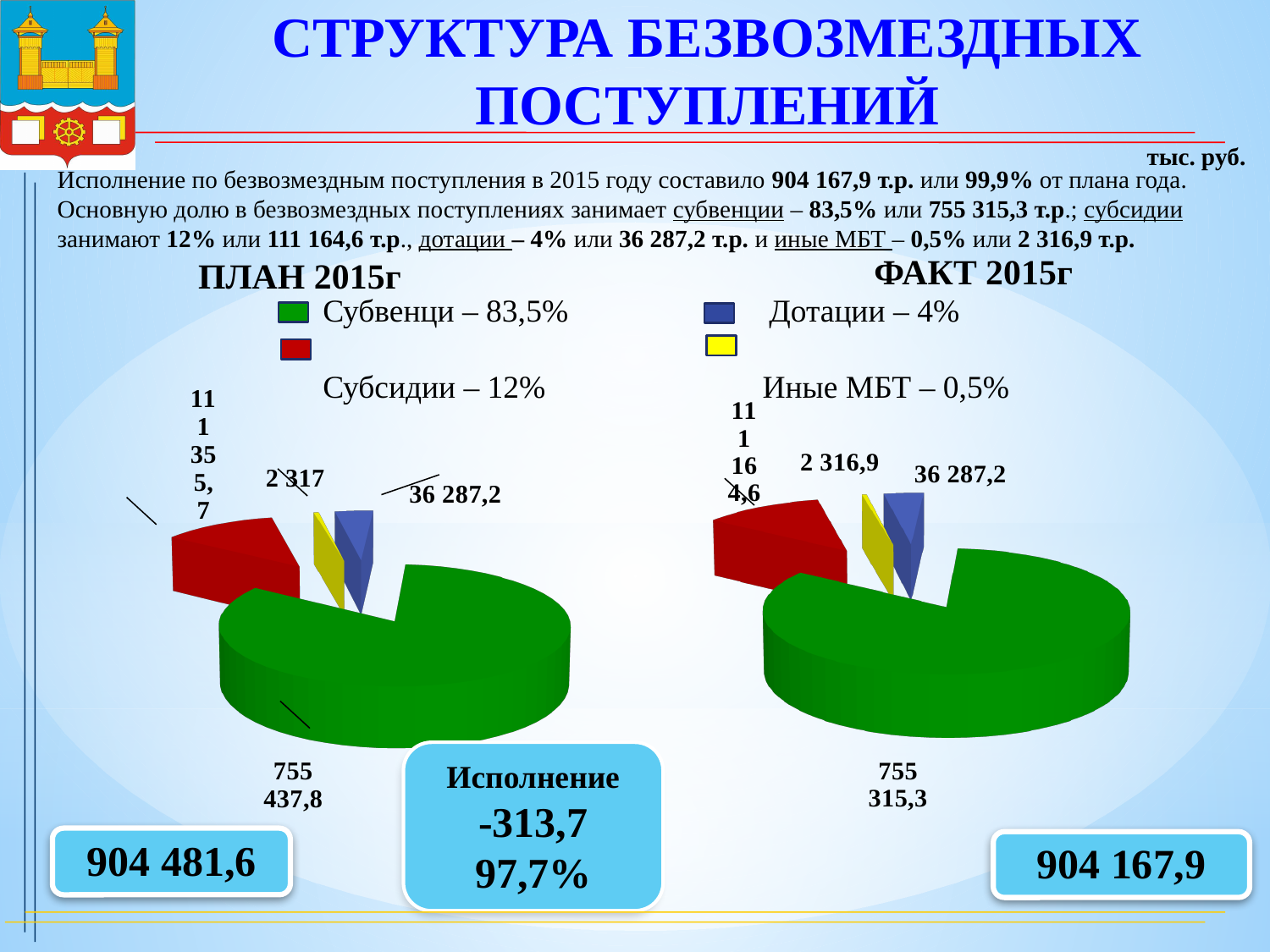
In the ФАКТ 2015г chart, what is the value of the Субсидии slice? 111 164,6 In the ПЛАН 2015г chart, which is larger: Субсидии or Дотации? Субсидии How many slices does the ФАКТ 2015г pie chart have? 4 What type of chart is used for ПЛАН 2015г and ФАКТ 2015г? Pie chart In the ПЛАН 2015г chart, what is the value of the Субвенции slice? 755 437,8 In the ПЛАН 2015г chart, which category has the smallest slice? Иные МБТ In the ФАКТ 2015г chart, which category has the largest slice? Субвенции In the ФАКТ 2015г chart, what is the value of the Дотации slice? 36 287,2 In the ФАКТ 2015г chart, what is the difference between the Дотации value and the Иные МБТ value? 33 970,3 In the ФАКТ 2015г chart, what is the value of the Субвенции slice? 755 315,3 According to the legend, what share of the pie do Субсидии make up? 12% In the ПЛАН 2015г chart, what is the value of the Иные МБТ slice? 2 317